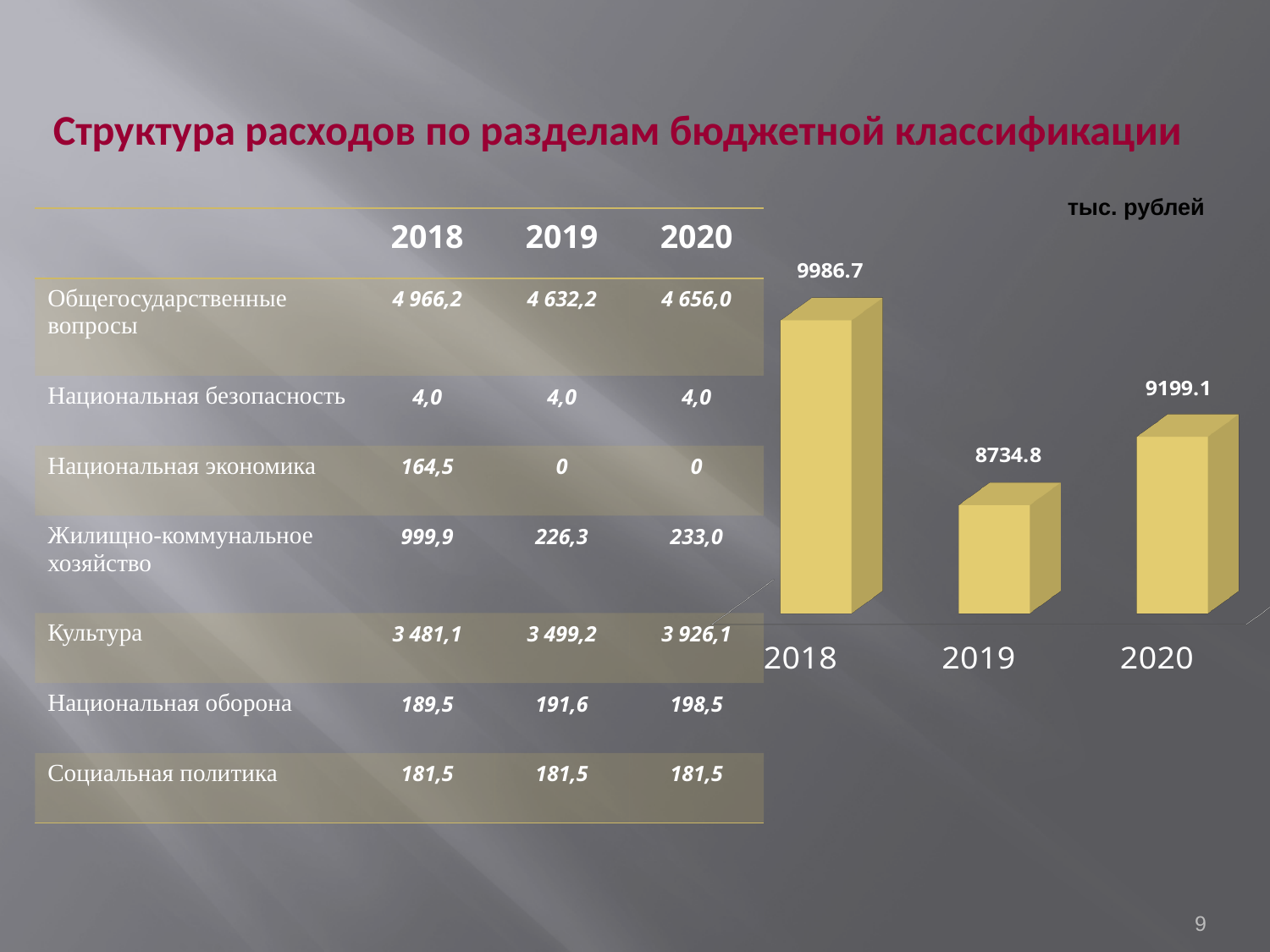
In the bar chart, which is larger: the value for 2020 or the value for 2019? 2020 In the bar chart, what is the difference between the 2018 and 2019 values? 1251.9 How many bars are plotted in the bar chart? 3 What unit is indicated above the bar chart? тыс. рублей In the bar chart, what is the value for 2019? 8734.8 In the bar chart, what is the value for 2018? 9986.7 What type of chart is shown on the right side of the slide? bar chart In the bar chart, what is the value for 2020? 9199.1 In the bar chart, which year has the lowest value? 2019 In the bar chart, what is the difference between the 2020 and 2019 values? 464.3 In the bar chart, does the value rise or fall from 2018 to 2019? fall In the bar chart, which year has the highest value? 2018